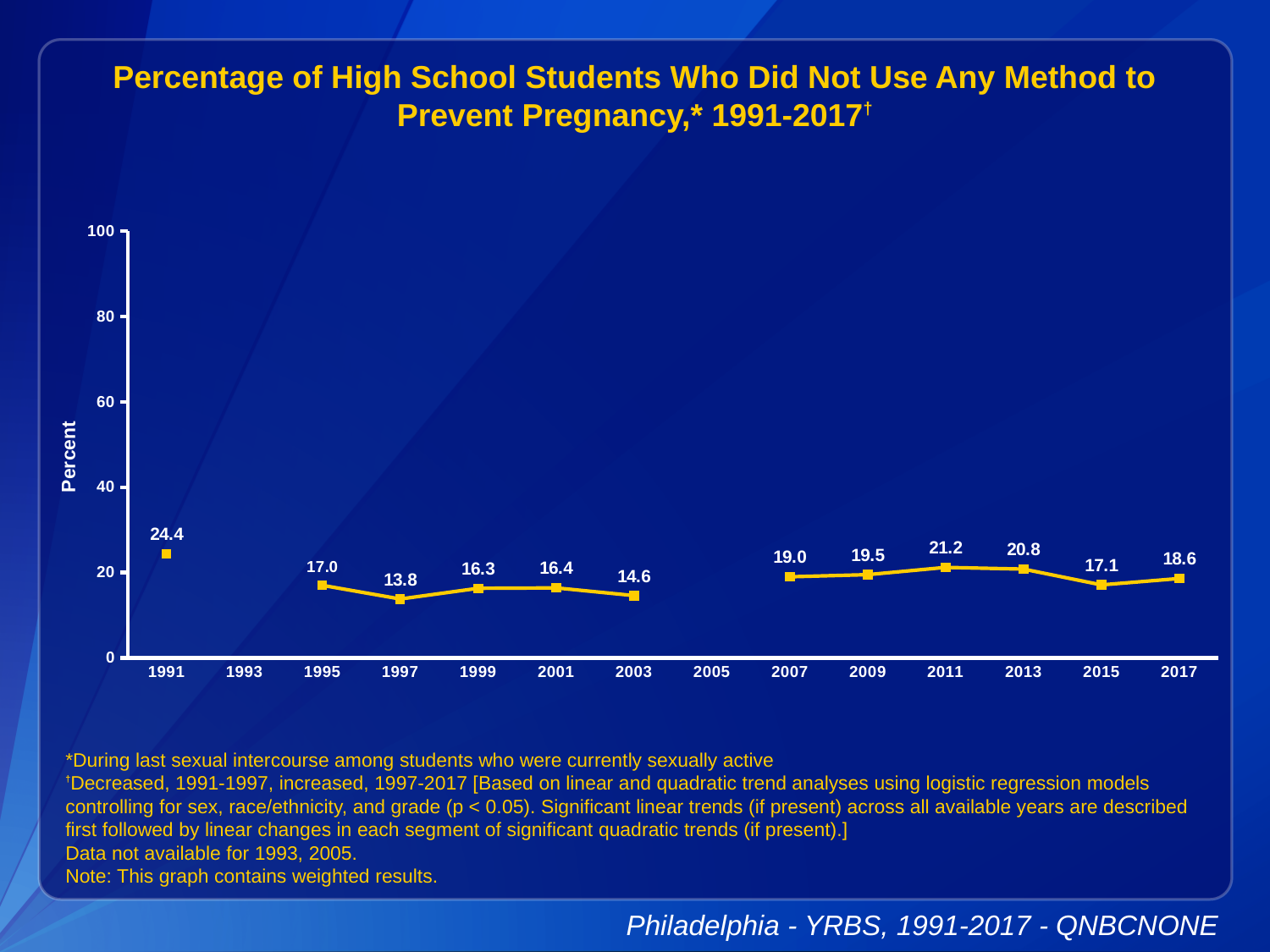
What is the value for 1991? 24.4 Do the values rise or fall from 1991 to 1997? fall Which is larger, the value for 2013 or the value for 2015? 2013 What is the value for 2017? 18.6 Is the value for 2003 greater or less than 20? less How many years have data points plotted? 12 What is the label on the y axis? Percent Which year has the lowest value? 1997 What is the value for 2011? 21.2 What is the difference between the values for 1991 and 1997? 10.6 What kind of chart is this? line chart Which year has the highest value? 1991